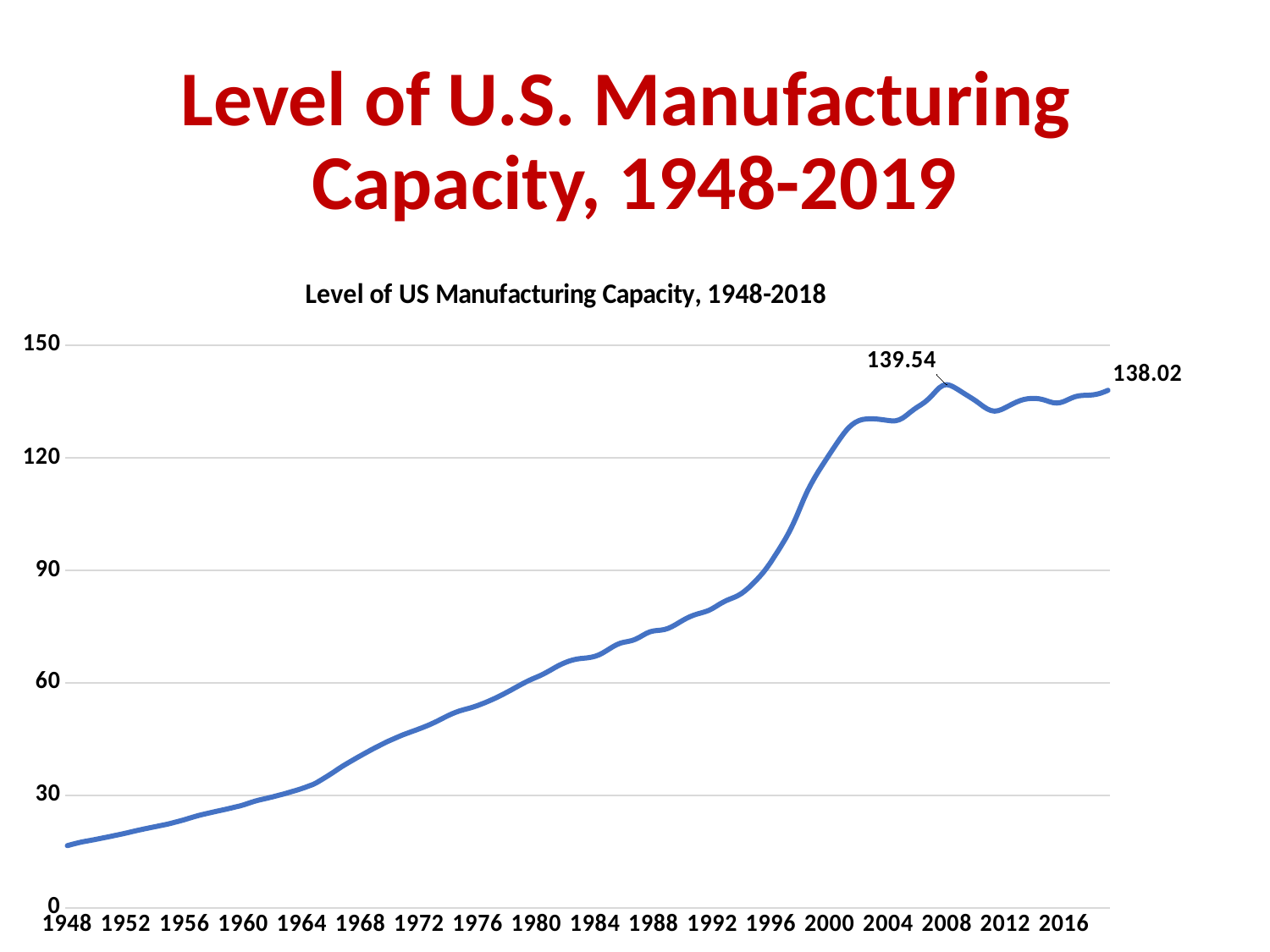
Which is larger, the labeled peak value or the labeled final value? 139.54 What kind of chart is shown on the slide? line chart What is the difference between the labeled peak value and the labeled final value? 1.52 Is the value for 1972 greater or less than 60? less How many lines are plotted on the chart? 1 What is the chart's title? Level of US Manufacturing Capacity, 1948-2018 Does the line generally rise or fall from 1948 to 2008? rise Is the value for 1948 greater or less than 30? less What is the labeled value at the end of the line? 138.02 Is the value for 2004 greater or less than 120? greater Around which year does the line reach its labeled peak of 139.54? 2008 What is the labeled peak value of the line? 139.54